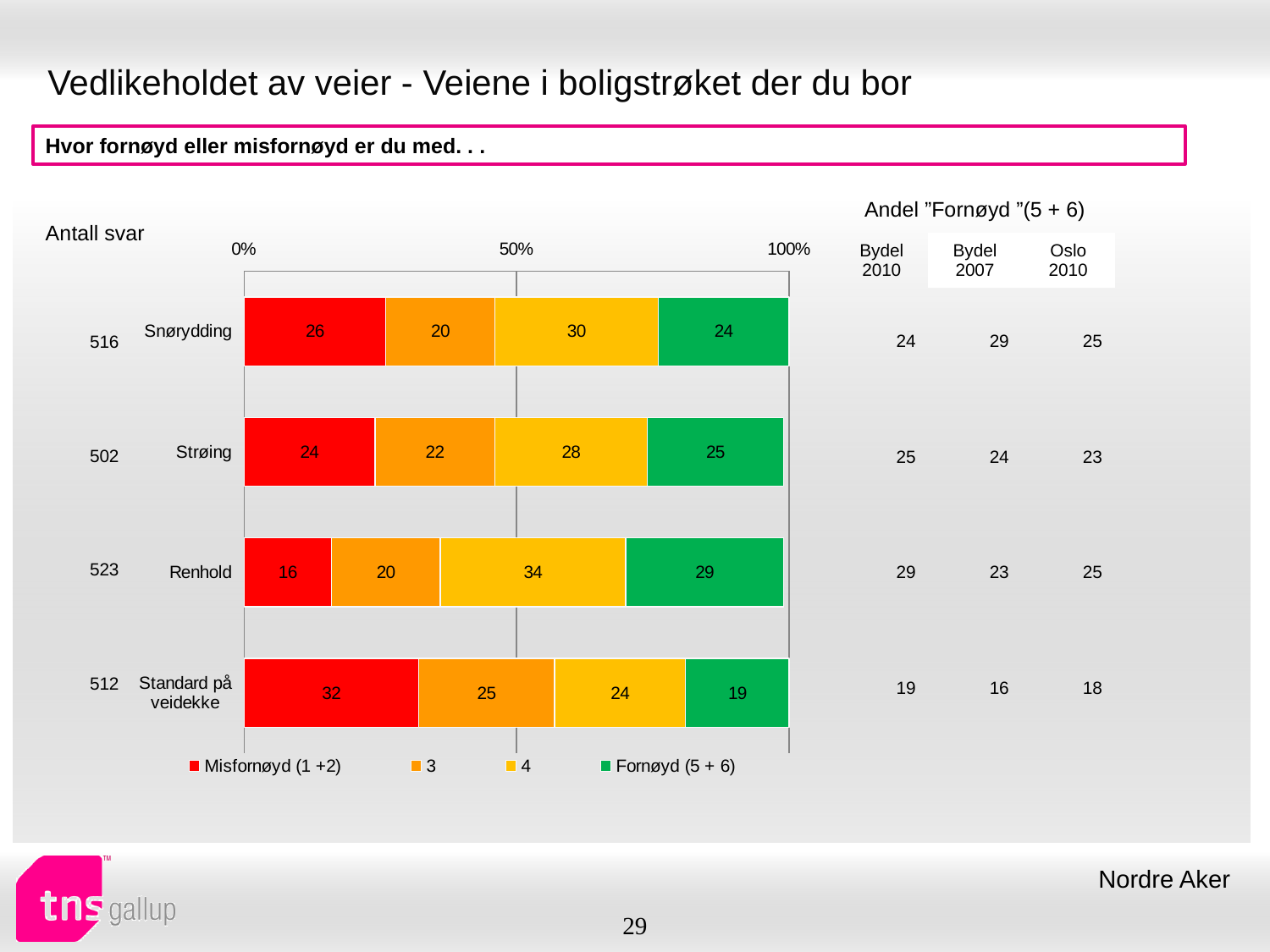
What is the value of the '4' segment for Strøing? 28 What is the value of the '3' segment for Standard på veidekke? 25 What is the total of the stacked bar for Renhold? 99 Which is larger: the 'Fornøyd (5 + 6)' value for Renhold or for Snørydding? Renhold How many series does the legend list? 4 How many categories are shown on the bar chart? 4 What is the difference between the 'Misfornøyd (1 +2)' values for Standard på veidekke and Renhold? 16 Which category has the highest 'Misfornøyd (1 +2)' value? Standard på veidekke What is the value of the 'Misfornøyd (1 +2)' segment for Snørydding? 26 What kind of chart is shown on the slide? Stacked bar chart What is the value of the 'Fornøyd (5 + 6)' segment for Renhold? 29 Which category has the lowest 'Fornøyd (5 + 6)' value? Standard på veidekke